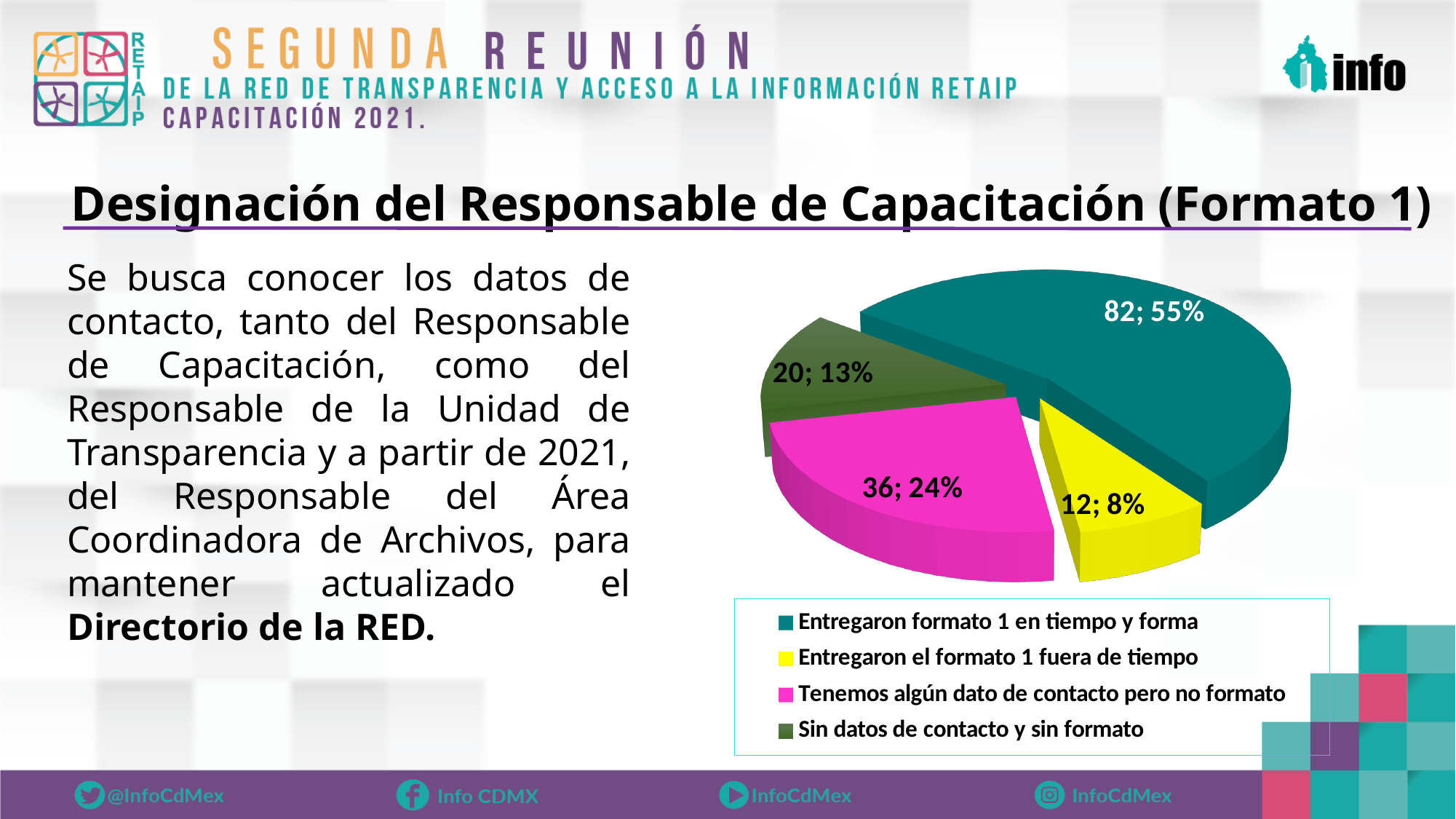
What is the value for 'Tenemos algún dato de contacto pero no formato'? 36; 24% What is the value for 'Entregaron el formato 1 fuera de tiempo'? 12; 8% What is the value for 'Sin datos de contacto y sin formato'? 20; 13% How many slices does the pie chart have? 4 How many entries does the legend list? 4 Which category has the largest slice? Entregaron formato 1 en tiempo y forma What is the difference in count between 'Entregaron formato 1 en tiempo y forma' and 'Tenemos algún dato de contacto pero no formato'? 46 Which is larger: 'Sin datos de contacto y sin formato' or 'Entregaron el formato 1 fuera de tiempo'? Sin datos de contacto y sin formato What is the value for 'Entregaron formato 1 en tiempo y forma'? 82; 55% What share of the pie does 'Tenemos algún dato de contacto pero no formato' represent? 24% What kind of chart is shown on the slide? pie chart Which category has the smallest slice? Entregaron el formato 1 fuera de tiempo